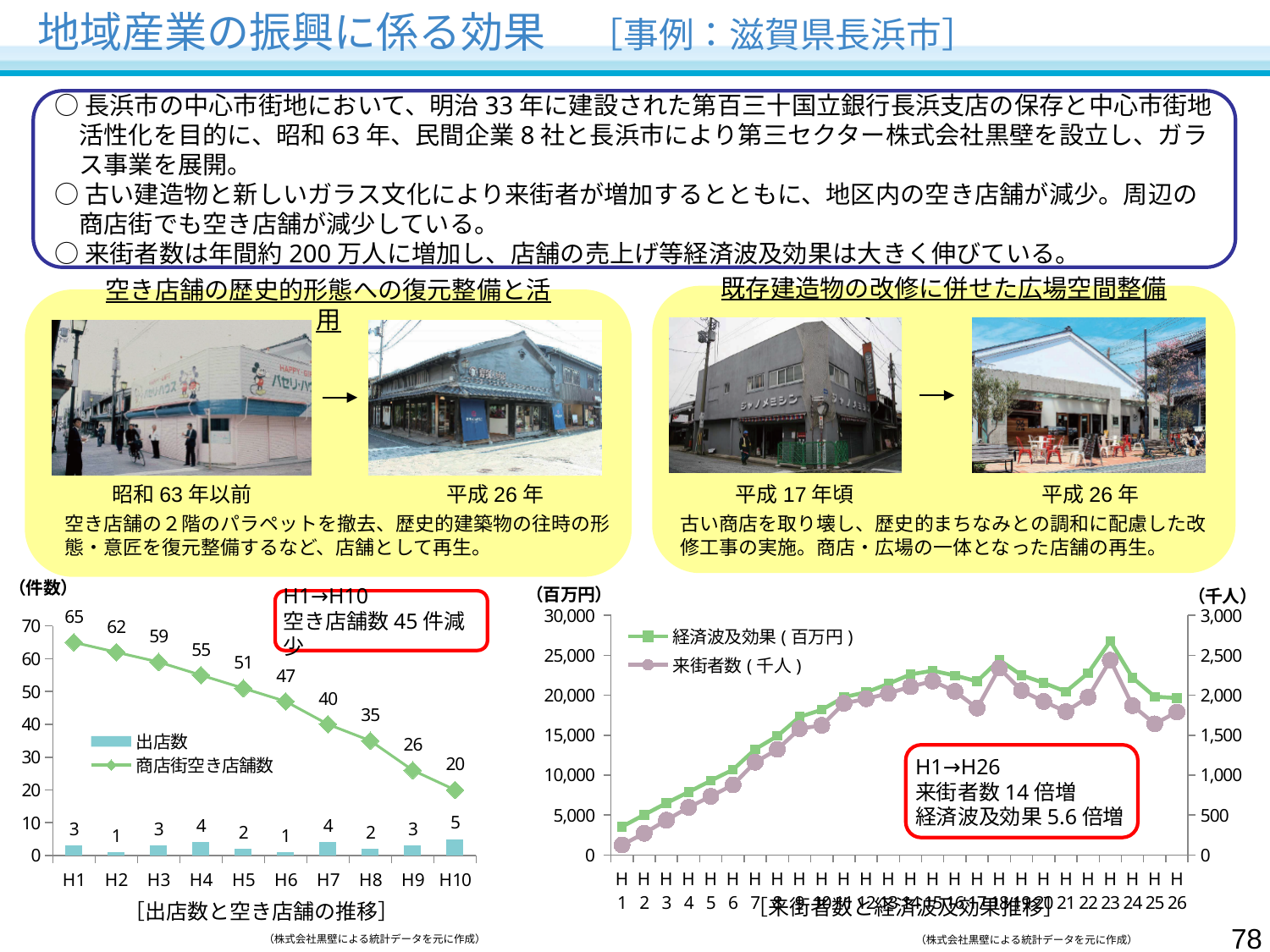
In the left chart (出店数と空き店舗の推移), which is larger, 商店街空き店舗数 for H7 or for H8? H7 In the left chart (出店数と空き店舗の推移), which year has the highest 出店数? H10 In the left chart (出店数と空き店舗の推移), what is the value of 出店数 for H4? 4 In the right chart (来街者数と経済波及効果推移), what unit is shown on the right-hand axis? 千人 In the left chart (出店数と空き店舗の推移), what is the value of 商店街空き店舗数 for H10? 20 In the left chart (出店数と空き店舗の推移), how many years are shown on the x axis? 10 In the left chart (出店数と空き店舗の推移), does 商店街空き店舗数 rise or fall from H1 to H10? fall In the right chart (来街者数と経済波及効果推移), is the value of 経済波及効果 for H1 greater or less than 5,000? less In the left chart (出店数と空き店舗の推移), what is the value of 商店街空き店舗数 for H1? 65 In the right chart (来街者数と経済波及効果推移), is the value of 経済波及効果 for H23 greater or less than 25,000? greater In the left chart (出店数と空き店舗の推移), what is the difference in 商店街空き店舗数 between H1 and H10? 45 In the right chart (来街者数と経済波及効果推移), how many series does the legend list? 2